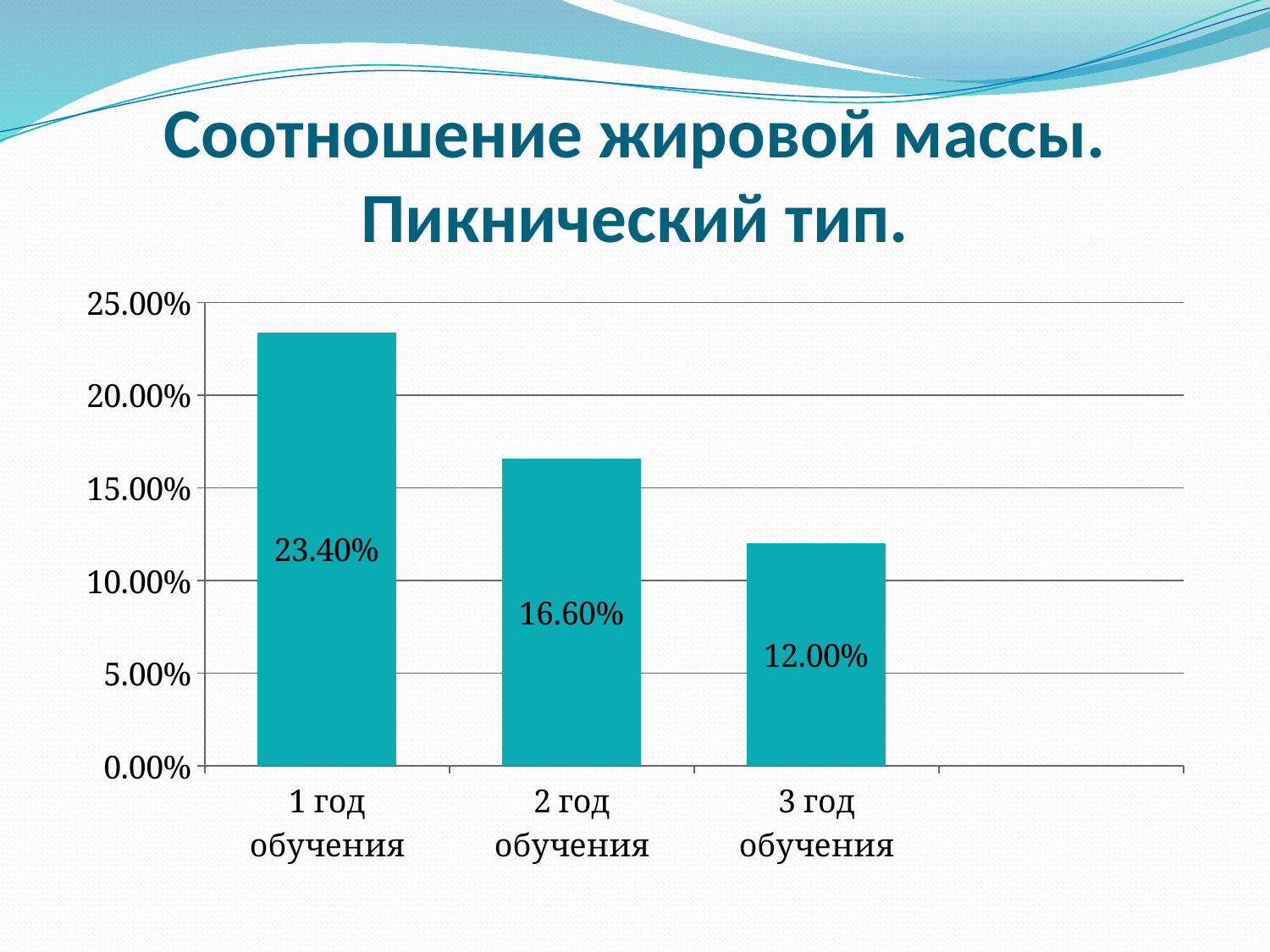
Which is larger, the value for 2 год обучения or 3 год обучения? 2 год обучения What is the difference between the values for 1 год обучения and 2 год обучения? 6.80% How many categories are shown on the x axis? 3 Is the value for 2 год обучения greater or less than 15.00%? greater Which category has the highest value? 1 год обучения Which category has the lowest value? 3 год обучения What is the value for 2 год обучения? 16.60% What kind of chart is shown on the slide? bar chart What is the value for 1 год обучения? 23.40% What is the value for 3 год обучения? 12.00% Do the values rise or fall from 1 год обучения to 3 год обучения? fall What is the difference between the values for 1 год обучения and 3 год обучения? 11.40%